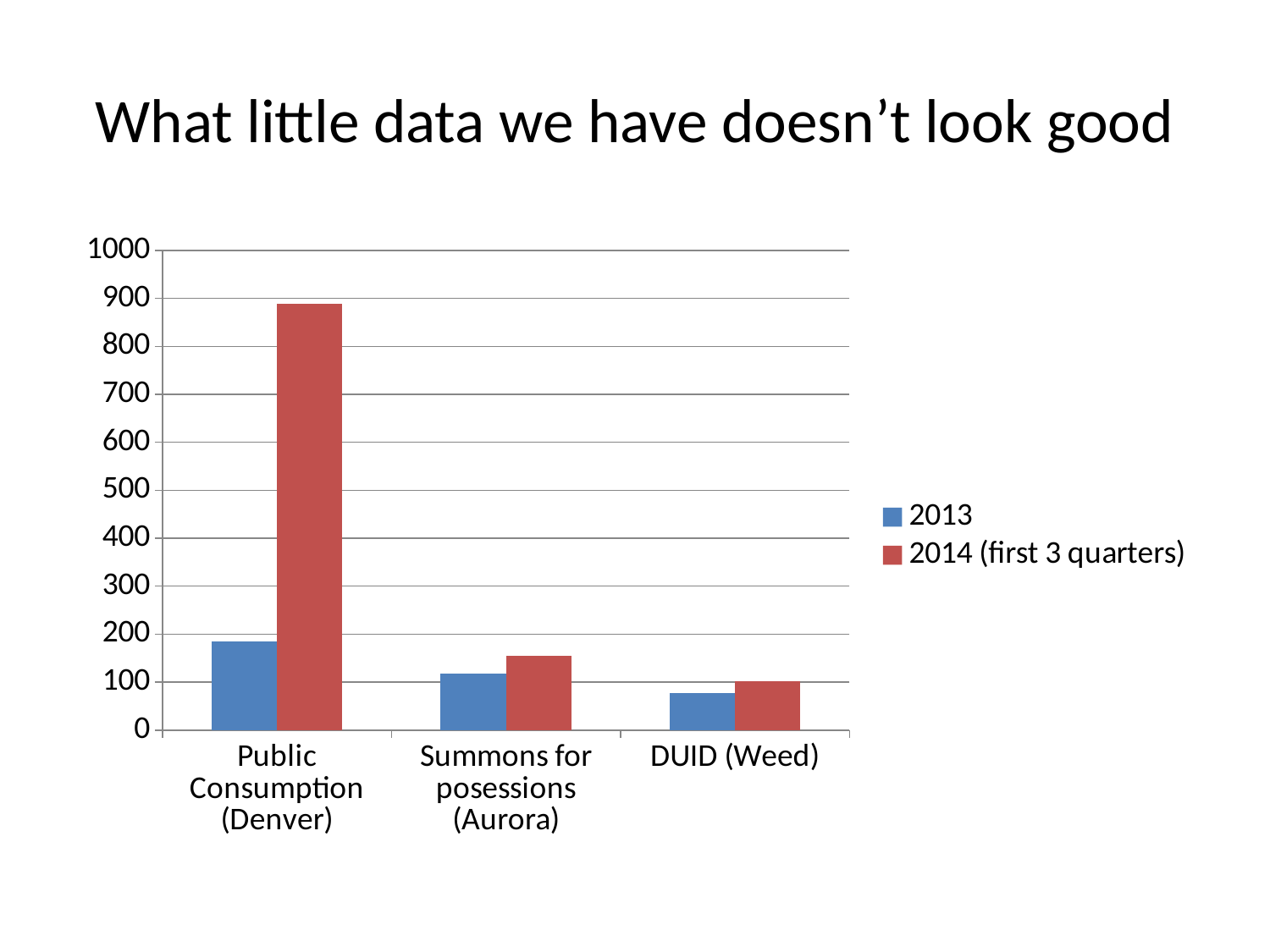
How many categories are shown on the x axis of the chart? 3 How many series does the chart's legend list? 2 For Public Consumption (Denver), which series has the larger value, 2013 or 2014 (first 3 quarters)? 2014 (first 3 quarters) What is the title of the slide containing the chart? What little data we have doesn't look good Which category has the lowest value for the 2013 series? DUID (Weed) Is the 2013 value for DUID (Weed) greater or less than 100? less Is the 2013 value for Summons for posessions (Aurora) greater or less than 100? greater Which category has the highest value for the 2014 (first 3 quarters) series? Public Consumption (Denver) Is the 2013 value for Public Consumption (Denver) greater or less than 200? less What kind of chart is shown on the slide? bar chart Which is larger: the 2013 value for Summons for posessions (Aurora) or the 2013 value for DUID (Weed)? Summons for posessions (Aurora)